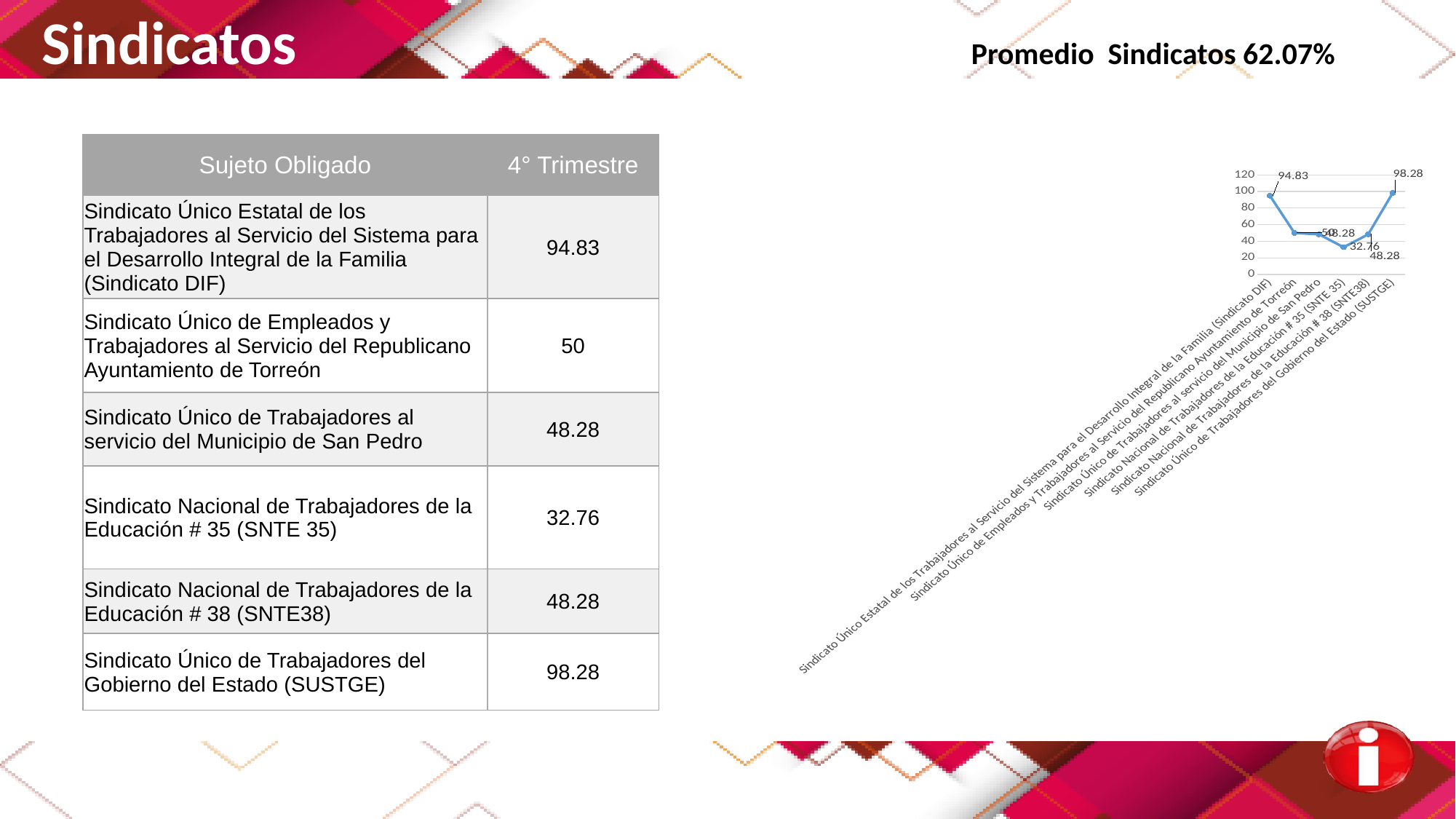
Which is larger, the value for Sindicato DIF or the value for SUSTGE? SUSTGE What is the value for SUSTGE in the chart? 98.28 What is the value for SNTE 35 in the chart? 32.76 How many data points are plotted on the line chart? 6 What is the difference between the values for SUSTGE and Sindicato DIF? 3.45 Which sujeto obligado has the lowest value in the chart? Sindicato Nacional de Trabajadores de la Educación # 35 (SNTE 35) Is the value for Sindicato Único de Empleados y Trabajadores al Servicio del Republicano Ayuntamiento de Torreón greater or less than 80? less Do the values rise or fall from Sindicato DIF to SNTE 35 along the x axis? fall Which sujeto obligado has the highest value in the chart? Sindicato Único de Trabajadores del Gobierno del Estado (SUSTGE) What is the difference between the values for Sindicato DIF and SNTE 35? 62.07 What is the value for Sindicato DIF in the chart? 94.83 What kind of chart is shown on the slide? line chart